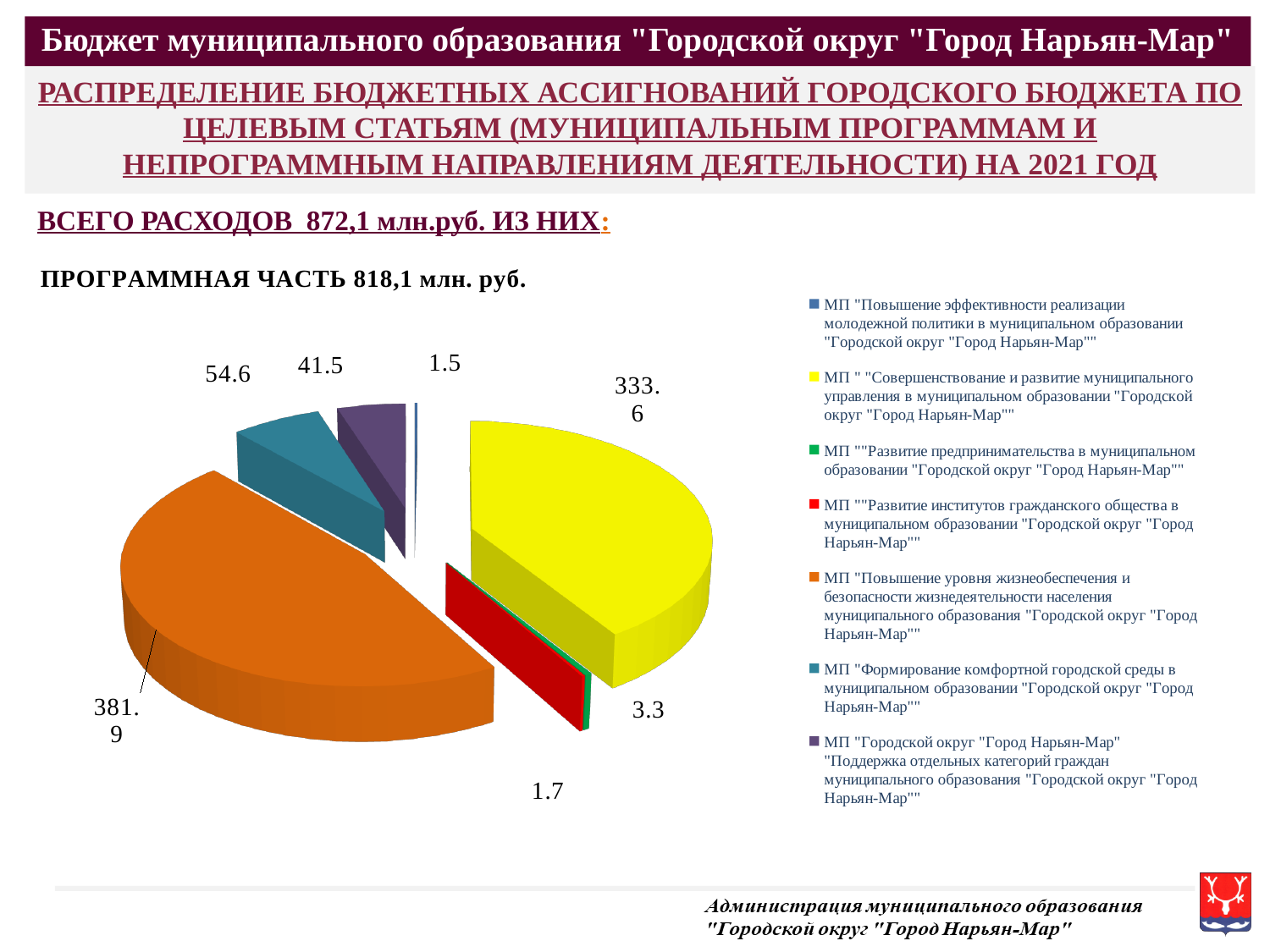
What is the value of the slice for МП "Совершенствование и развитие муниципального управления"? 333.6 What is the difference between the values of the two largest slices (381.9 and 333.6)? 48.3 What is the value of the slice for МП "Формирование комфортной городской среды"? 54.6 Which is larger: the slice for МП "Формирование комфортной городской среды" or the slice for МП "Поддержка отдельных категорий граждан"? МП "Формирование комфортной городской среды" What is the value of the slice for МП "Развитие институтов гражданского общества"? 1.7 What is the value of the slice for МП "Повышение уровня жизнеобеспечения и безопасности жизнедеятельности населения"? 381.9 What total amount does the slide give for the program part (ПРОГРАММНАЯ ЧАСТЬ) shown in the pie chart? 818,1 млн. руб. Which program has the largest slice in the pie chart? МП "Повышение уровня жизнеобеспечения и безопасности жизнедеятельности населения" How many slices does the pie chart have? 7 How many entries does the legend of the pie chart list? 7 Which program has the smallest slice in the pie chart? МП "Повышение эффективности реализации молодежной политики" What type of chart is shown on the slide? pie chart